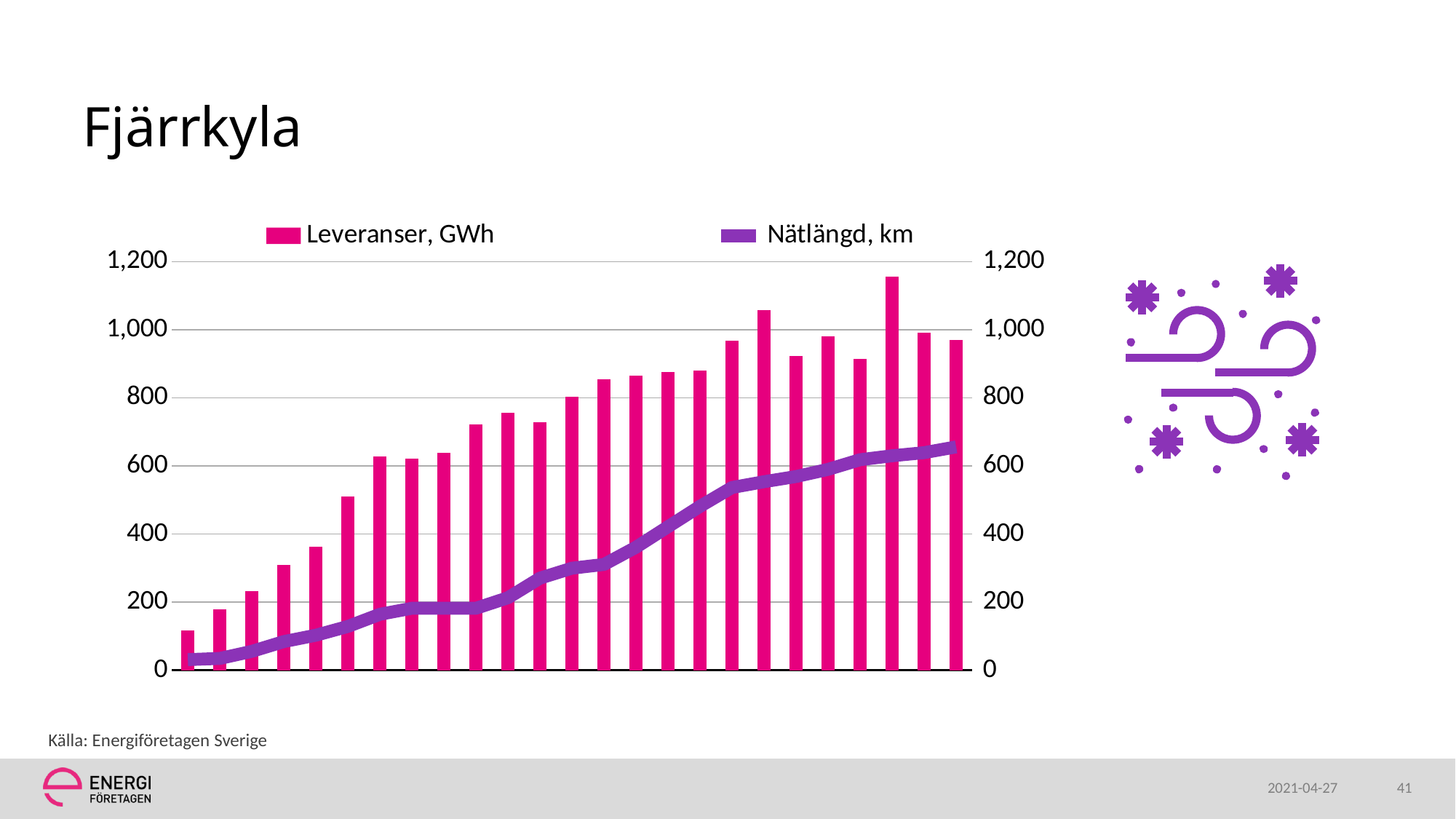
How many bars are plotted in the chart? 25 Is the tallest Leveranser, GWh bar greater or less than 1,000? greater Do the Nätlängd, km values generally rise or fall from left to right? Rise Is the first (leftmost) Nätlängd, km value greater or less than 200? less Is the last (rightmost) Nätlängd, km value greater or less than 600? greater Do the Leveranser, GWh bars generally rise or fall from left to right? Rise How many series does the legend list? 2 What kind of chart is shown on the slide? A combined bar and line chart Which series is plotted as bars? Leveranser, GWh Which series is plotted as a line? Nätlängd, km